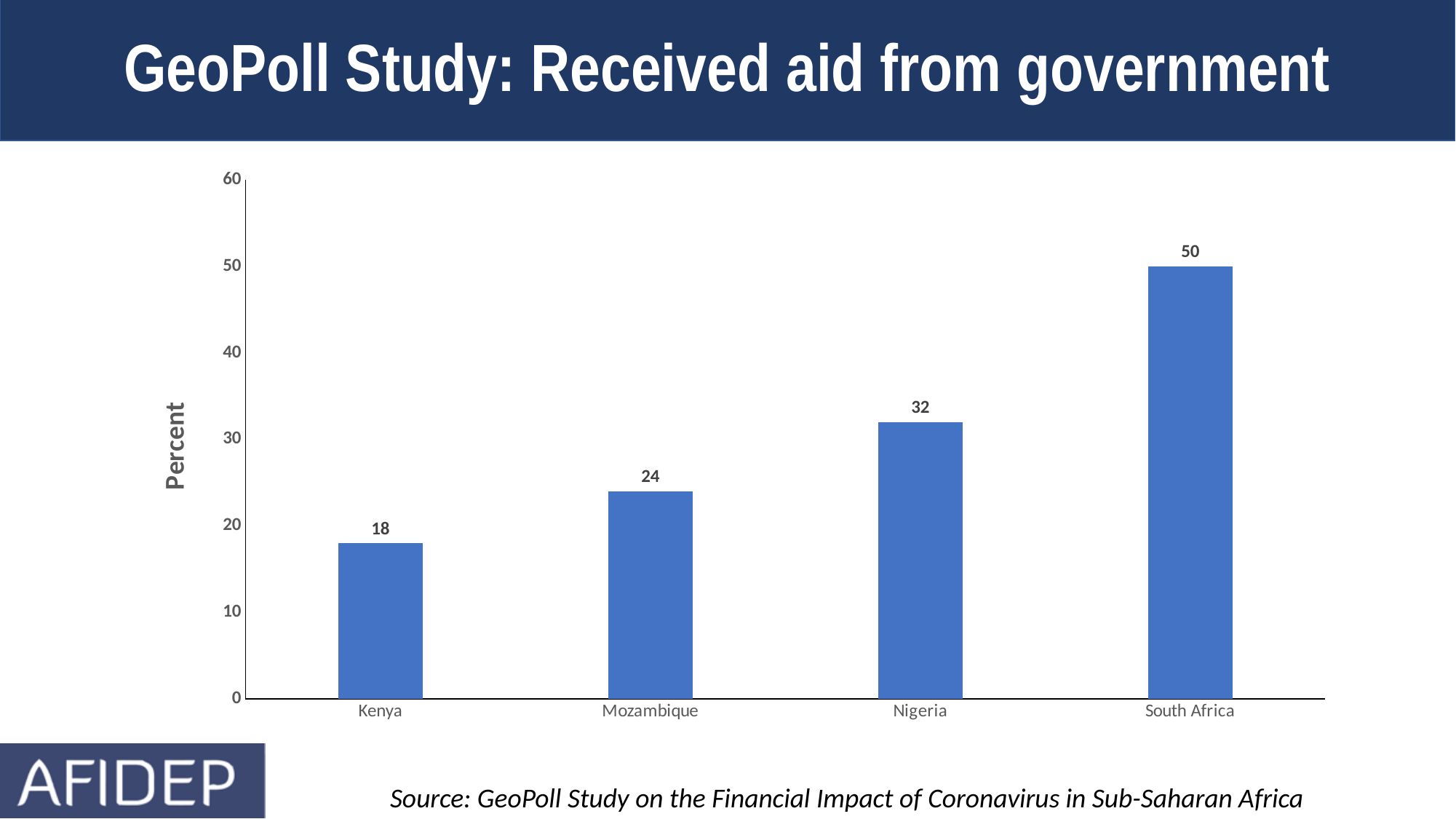
What is the value shown for South Africa? 50 What percentage of respondents in Kenya received aid from government? 18 Which country has the highest percentage of people who received aid from government? South Africa Do the values rise or fall moving from Kenya to South Africa along the x axis? Rise What is the difference between the values for Nigeria and Mozambique? 8 What is the difference between the values for South Africa and Kenya? 32 Which has a higher value, Mozambique or Nigeria? Nigeria Which country has the lowest percentage of people who received aid from government? Kenya What is the value shown for Nigeria? 32 What is the value shown for Mozambique? 24 What type of chart is shown on the slide? Bar chart How many countries are shown in the chart? 4